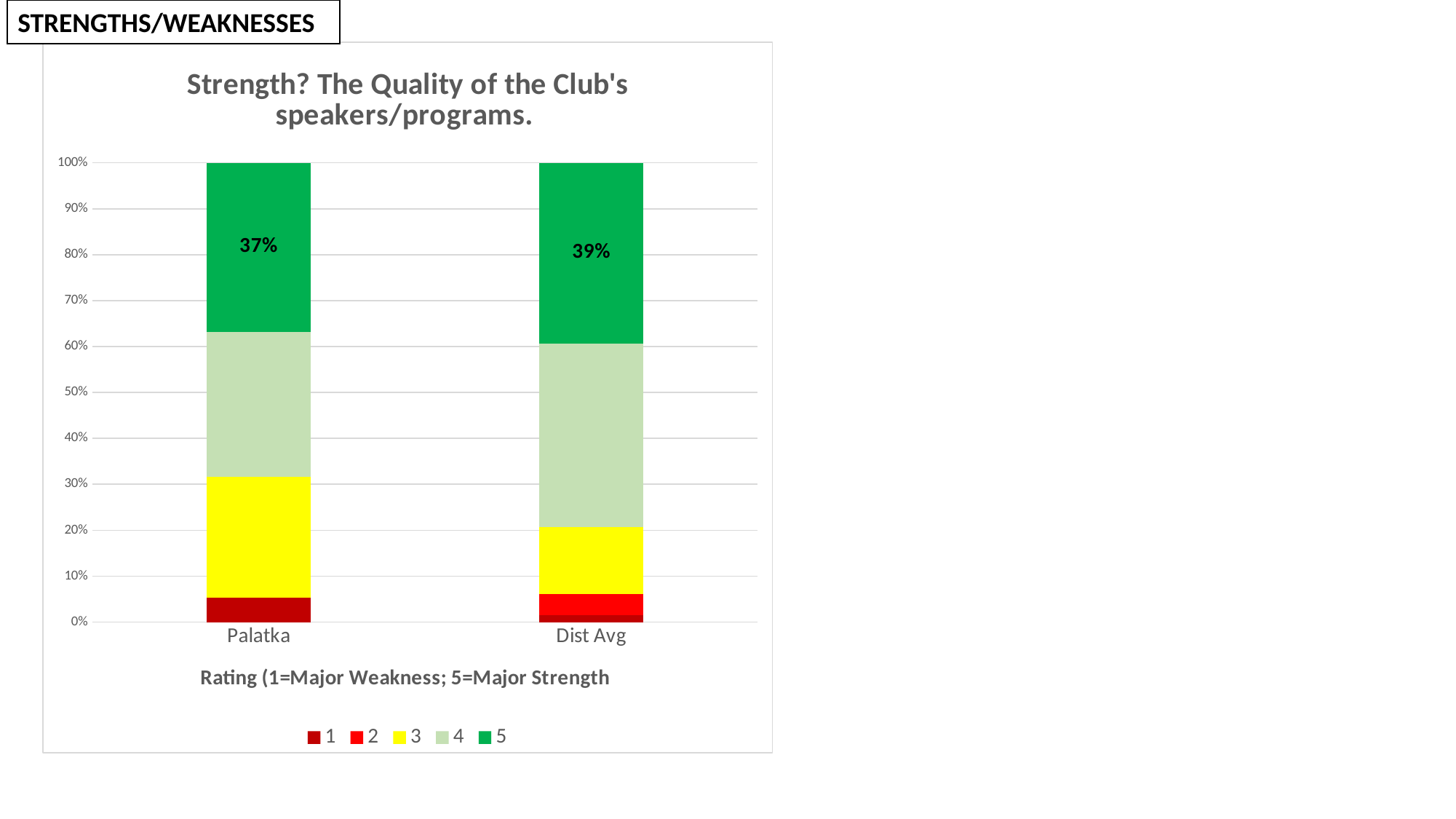
How many series does the legend list? 5 What is the share of rating 5 for Dist Avg? 39% What is the difference between the rating-5 share for Dist Avg and for Palatka? 2% What percentage of Palatka respondents gave a rating of 5? 37% Is the share of rating 3 for Palatka greater or less than 20%? greater Is the share of rating 1 for Palatka greater or less than 10%? less Which category has the larger share of rating 5, Palatka or Dist Avg? Dist Avg Is the share of rating 4 for Dist Avg greater or less than 30%? greater How many categories are shown on the x axis? 2 What kind of chart is shown on the slide? Stacked bar chart What colour represents rating 5 in the legend? Green What is the title of the chart? Strength? The Quality of the Club's speakers/programs.